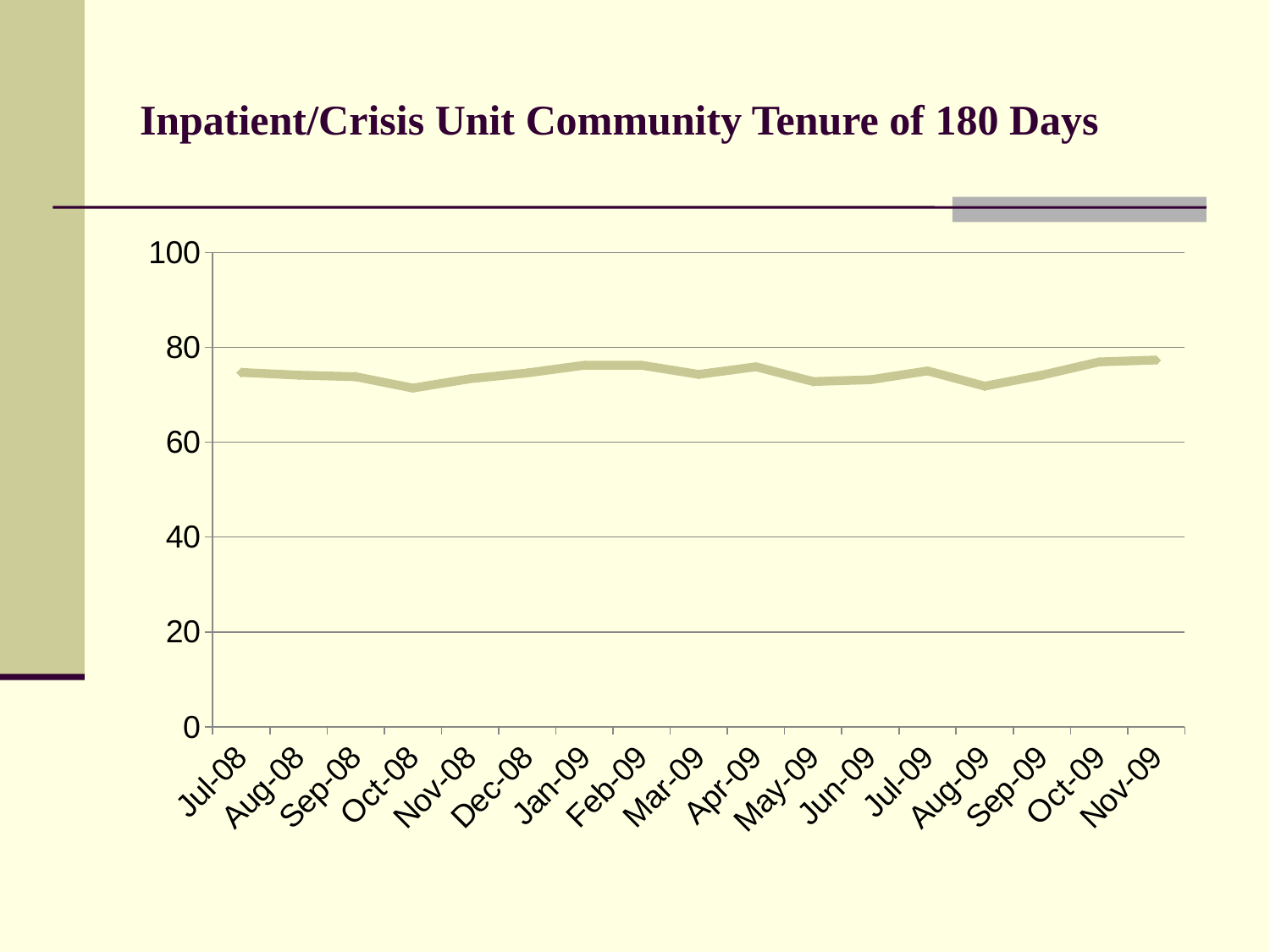
How many months are plotted along the x axis? 17 Which month is the first point on the x axis? Jul-08 Which is larger, the value for Nov-09 or the value for Oct-08? Nov-09 Is the value for Mar-09 greater or less than 100? less Is the value for Jan-09 greater or less than 60? greater What is the title of the chart? Inpatient/Crisis Unit Community Tenure of 180 Days Is the value for Oct-08 greater or less than 80? less What kind of chart is shown on the slide? line chart